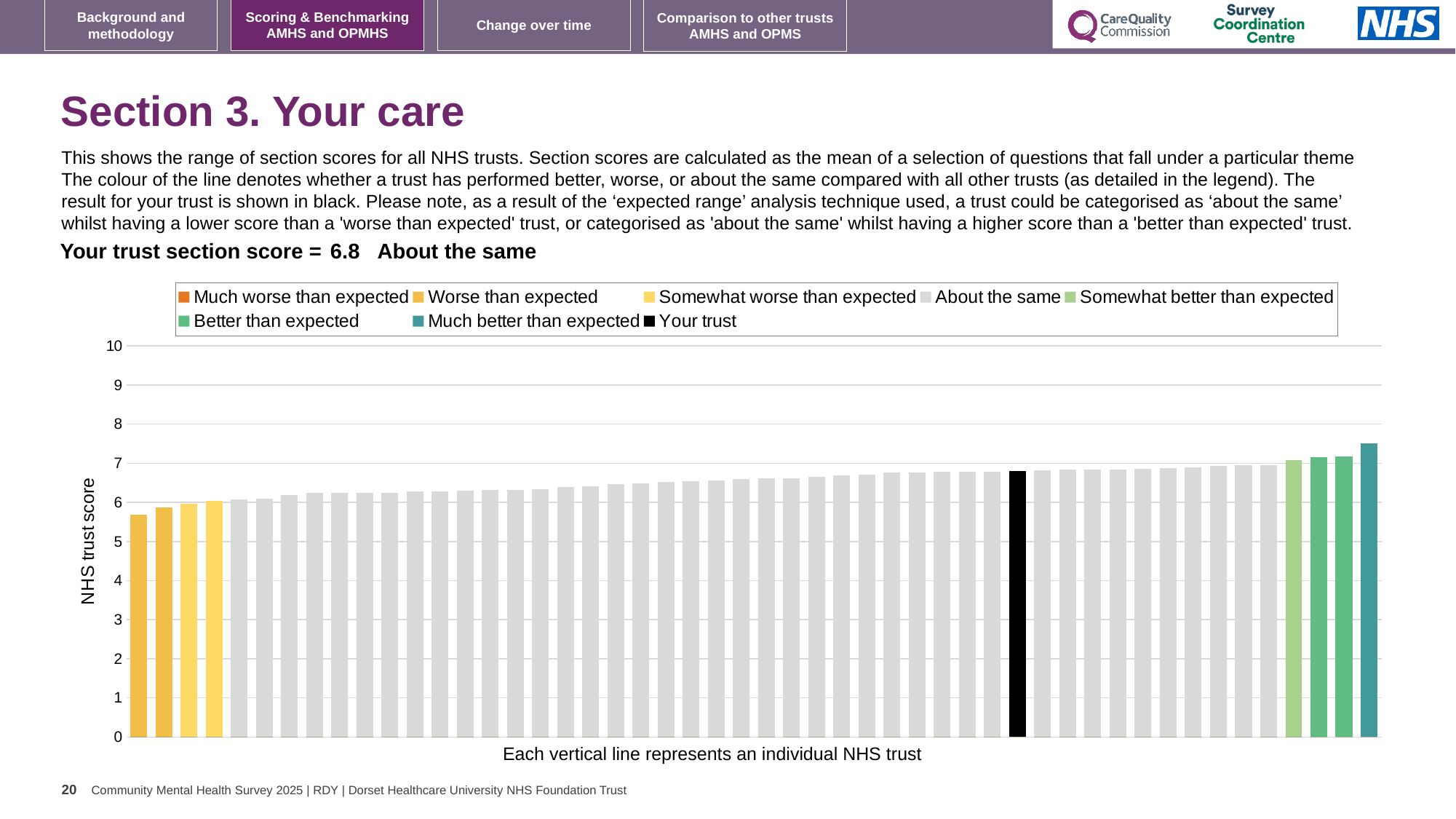
Is the value for the tallest bar in the chart greater or less than 7? greater What kind of chart is shown on the slide? bar chart What is the section score for your trust shown on the slide? 6.8 How many entries does the chart legend list? 8 What is the label of the y axis? NHS trust score Is the value for the black 'Your trust' bar greater or less than 6? greater What is the highest value shown on the y axis? 10 Is the value for the lowest bar in the chart greater or less than 6? less Which is larger: the value of the black 'Your trust' bar or the value of the leftmost bar? the black 'Your trust' bar Do the bar values rise or fall from left to right along the x axis? rise Which category is your trust placed in according to the slide? About the same